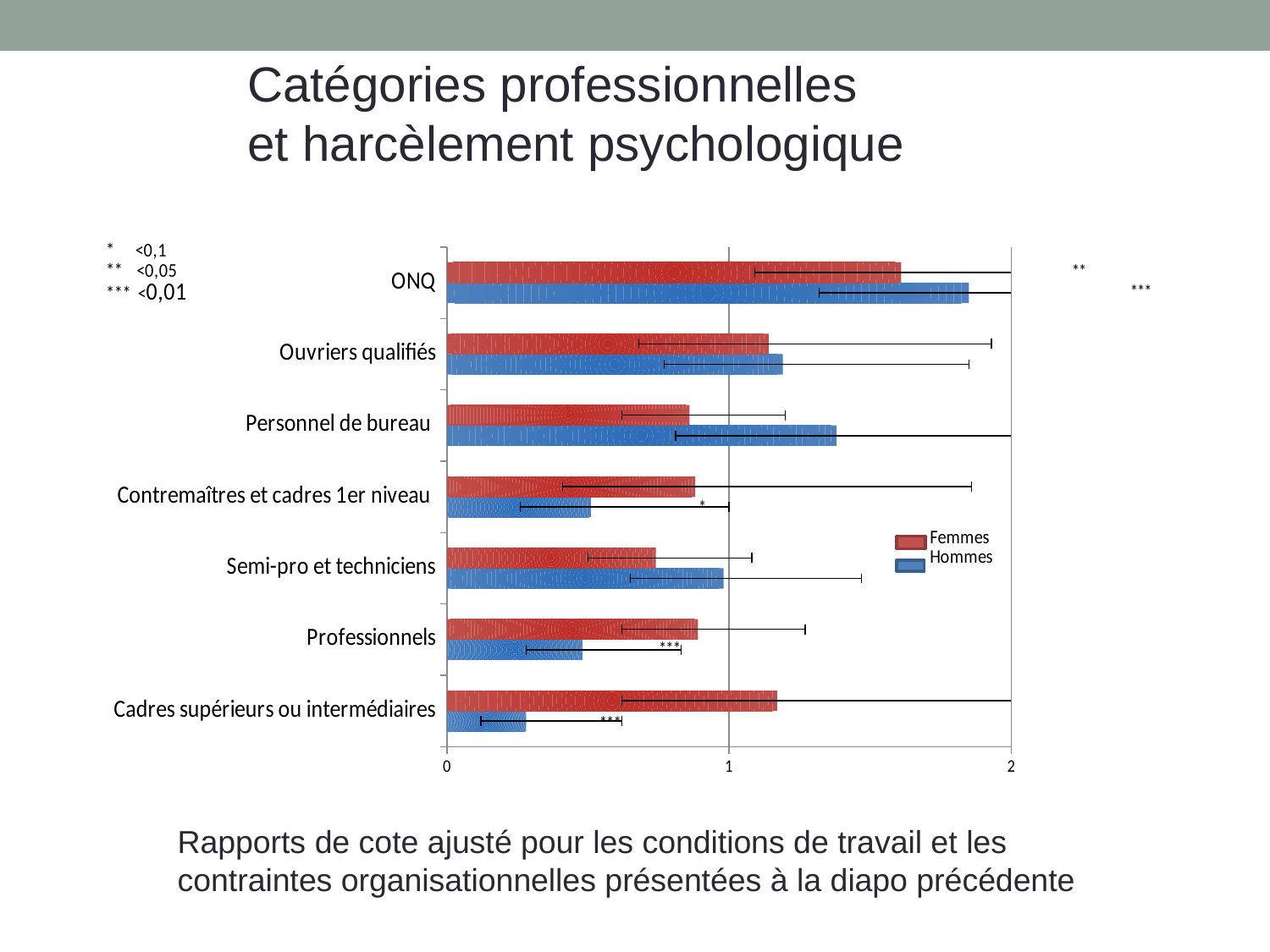
How many professional categories are plotted on the chart? 7 Which category has the lowest value for Hommes? Cadres supérieurs ou intermédiaires Which category has the highest value for Femmes? ONQ Is the value for Hommes in the Cadres supérieurs ou intermédiaires category greater or less than 1? less For Cadres supérieurs ou intermédiaires, which series has the larger value, Femmes or Hommes? Femmes What kind of chart is shown on the slide? bar chart For Personnel de bureau, which series has the larger value, Femmes or Hommes? Hommes How many series does the legend list? 2 Is the value for Femmes in the ONQ category greater or less than 1? greater Which category has the highest value for Hommes? ONQ Which colour represents the Hommes series in the legend? blue Is the value for Hommes in the Personnel de bureau category greater or less than 1? greater